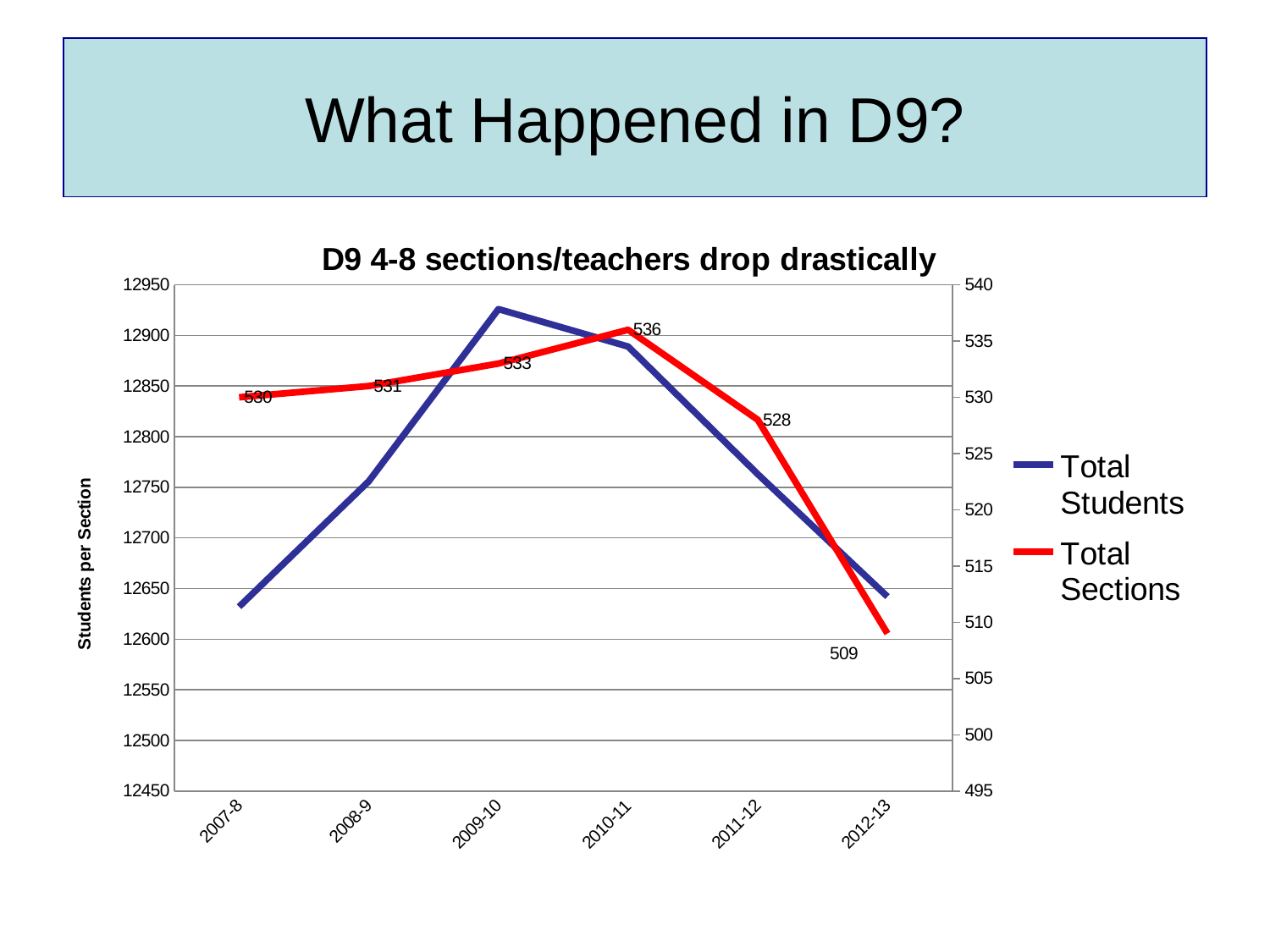
In which year is Total Sections lowest? 2012-13 What is the value of Total Sections in 2007-8? 530 What is the value of Total Sections in 2012-13? 509 Is the value for Total Students in 2007-8 greater or less than 12650? less Is the value for Total Students in 2009-10 greater or less than 12900? greater Which year has more Total Sections, 2008-9 or 2011-12? 2008-9 How many series does the legend list? 2 What kind of chart is shown on the slide? Line chart How many school years are shown on the x axis? 6 What is the difference between Total Sections in 2010-11 and 2012-13? 27 In which year is Total Sections highest? 2010-11 What is the value of Total Sections in 2010-11? 536